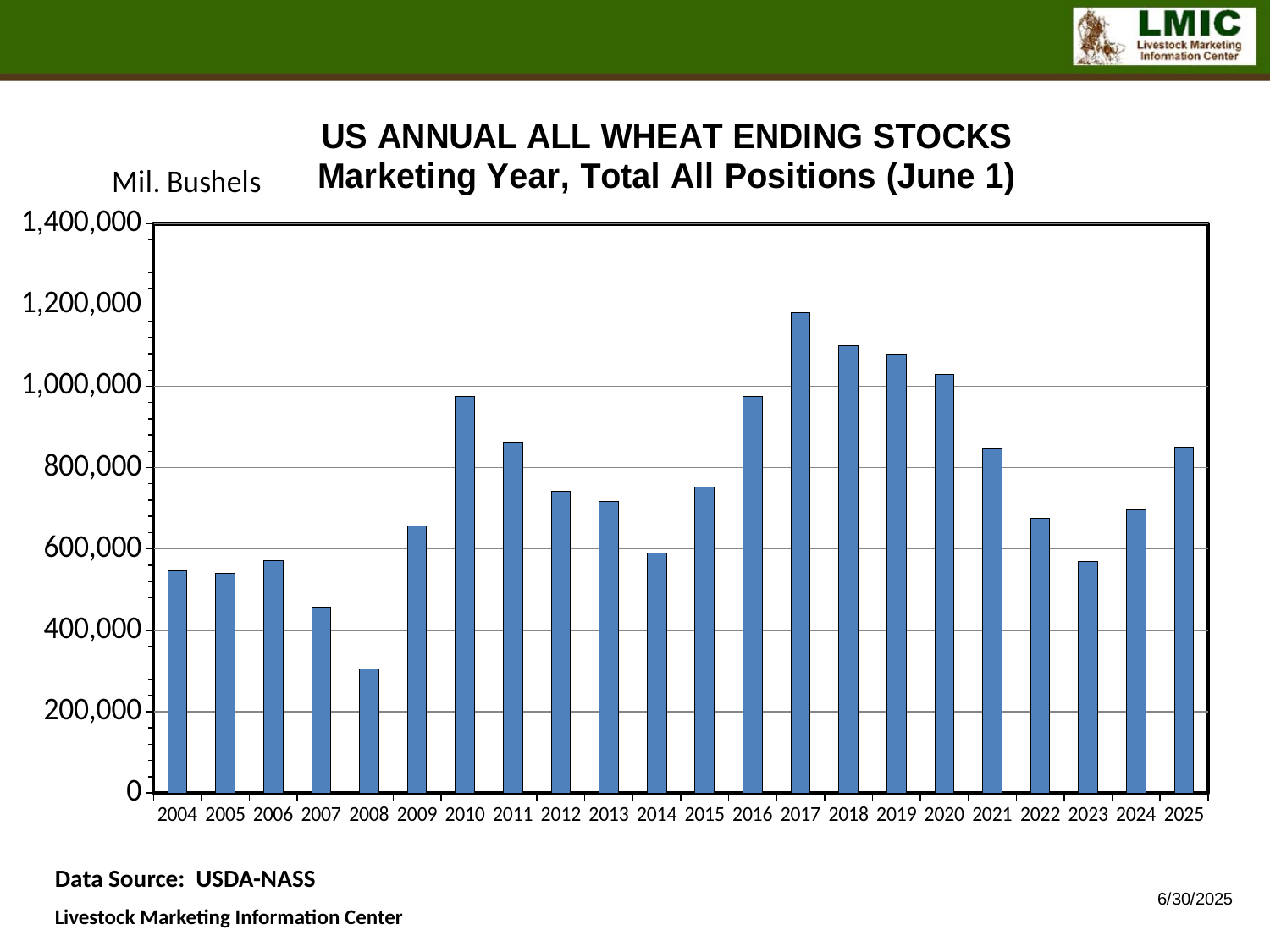
Which year has the lowest US annual all wheat ending stocks? 2008 Which year has the highest US annual all wheat ending stocks? 2017 Do the values rise or fall from 2017 to 2020? fall Is the value for 2010 greater or less than 1,000,000? less Is the value for 2017 greater or less than 1,000,000? greater Is the value for 2021 greater or less than 800,000? greater What unit is shown on the y axis of the chart? Mil. Bushels Which year has the larger value, 2007 or 2008? 2007 How many years are plotted on the chart? 22 What kind of chart is shown on the slide? bar chart Which year has the larger value, 2017 or 2018? 2017